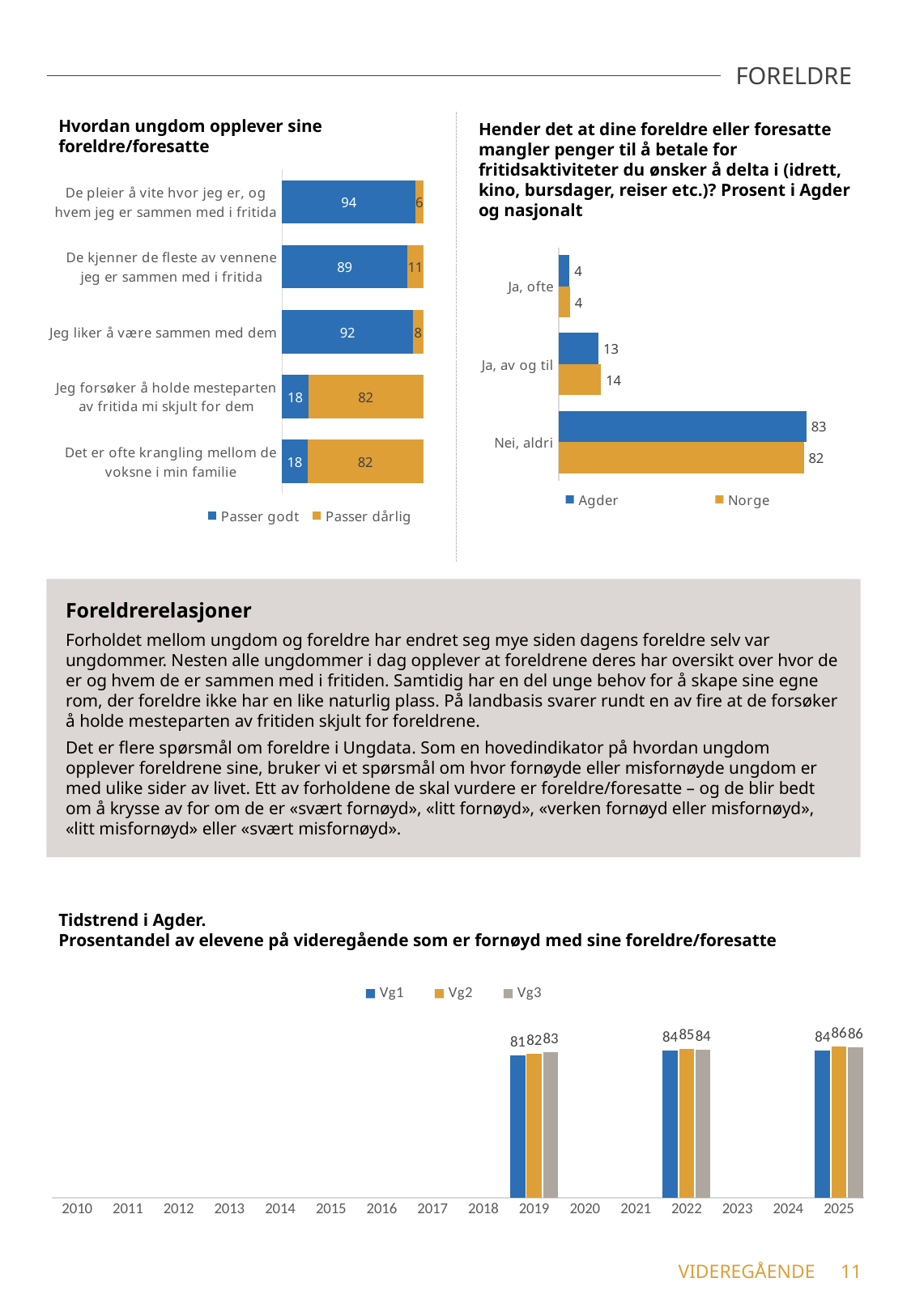
In the chart 'Hender det at dine foreldre eller foresatte mangler penger...', how many series does the legend list? 2 In the chart 'Hvordan ungdom opplever sine foreldre/foresatte', what is the 'Passer godt' value for 'De pleier å vite hvor jeg er, og hvem jeg er sammen med i fritida'? 94 In the chart 'Hender det at dine foreldre eller foresatte mangler penger...', which category has the lowest Norge value? Ja, ofte In the chart 'Hvordan ungdom opplever sine foreldre/foresatte', what is the 'Passer dårlig' value for 'De kjenner de fleste av vennene jeg er sammen med i fritida'? 11 In the chart 'Hvordan ungdom opplever sine foreldre/foresatte', what is the total of the stacked bar for 'Jeg liker å være sammen med dem'? 100 In the chart 'Hender det at dine foreldre eller foresatte mangler penger...', what is the difference between the Agder and Norge values for 'Nei, aldri'? 1 In the chart 'Hender det at dine foreldre eller foresatte mangler penger...', what is the Agder value for 'Ja, av og til'? 13 In the chart 'Tidstrend i Agder', what kind of chart is shown? Bar chart In the chart 'Tidstrend i Agder', what is the Vg2 value for 2025? 86 In the chart 'Hvordan ungdom opplever sine foreldre/foresatte', how many categories are shown? 5 In the chart 'Hvordan ungdom opplever sine foreldre/foresatte', which category has the highest 'Passer godt' value? De pleier å vite hvor jeg er, og hvem jeg er sammen med i fritida In the chart 'Tidstrend i Agder', do the Vg1 values rise or fall from 2019 to 2022? Rise